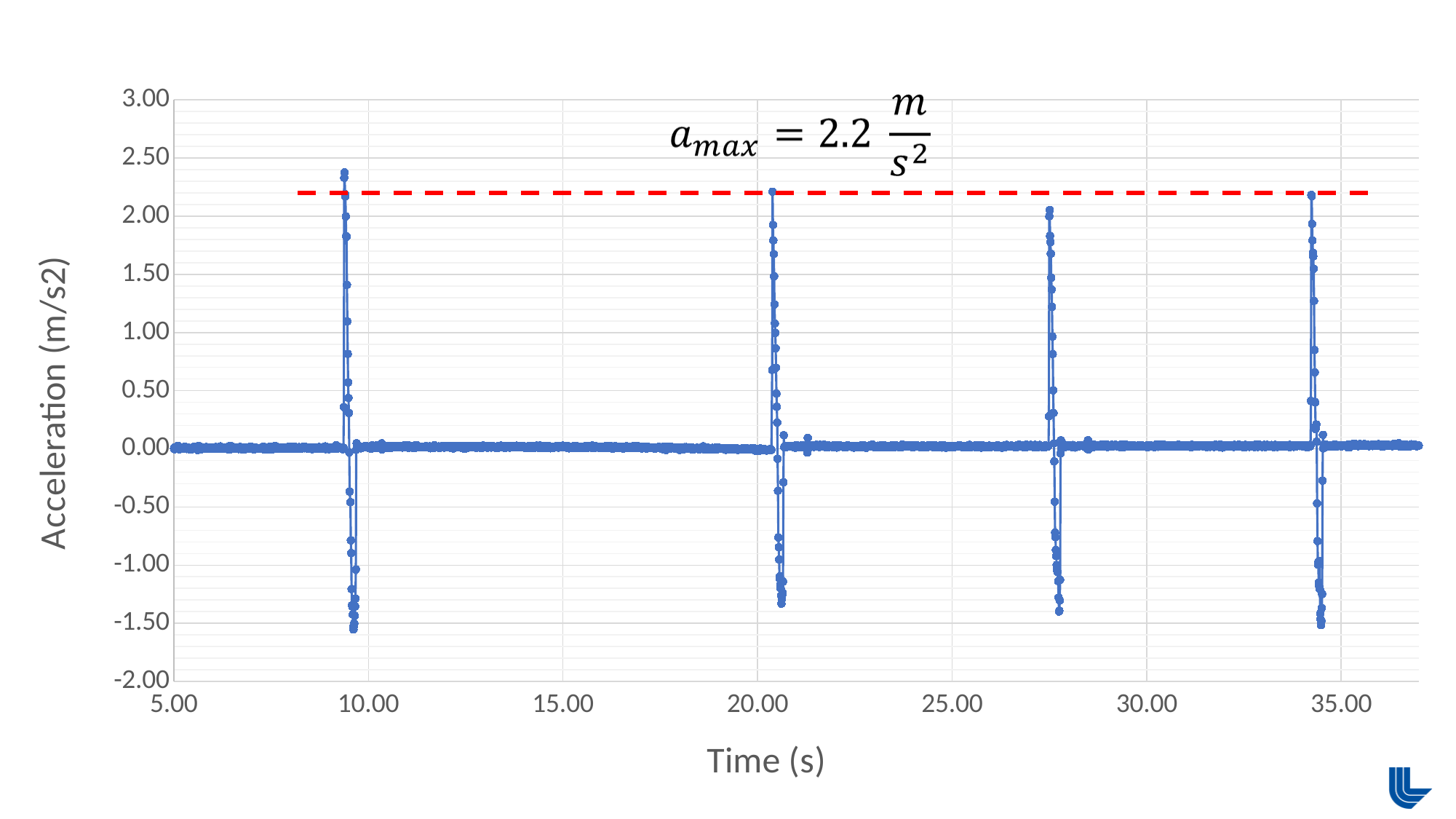
Is the peak of the third spike (near 27.5 s) greater or less than 2.50? less Is the acceleration at around 15 s greater or less than 0.50? less What is the lowest tick value shown on the y axis? -2.00 What is the label of the x axis? Time (s) How many large spikes in acceleration are plotted over the time range? 4 What is the highest tick value shown on the y axis? 3.00 Which has the higher peak acceleration, the first spike (near 9.5 s) or the third spike (near 27.5 s)? the first spike What kind of chart is shown on the slide? line chart Is the peak of the first spike (near 9.5 s) greater or less than 2.00? greater What value does the red dashed line labelled a_max mark? 2.2 m/s² Which spike reaches the highest positive acceleration? the first spike (near 9.5 s)